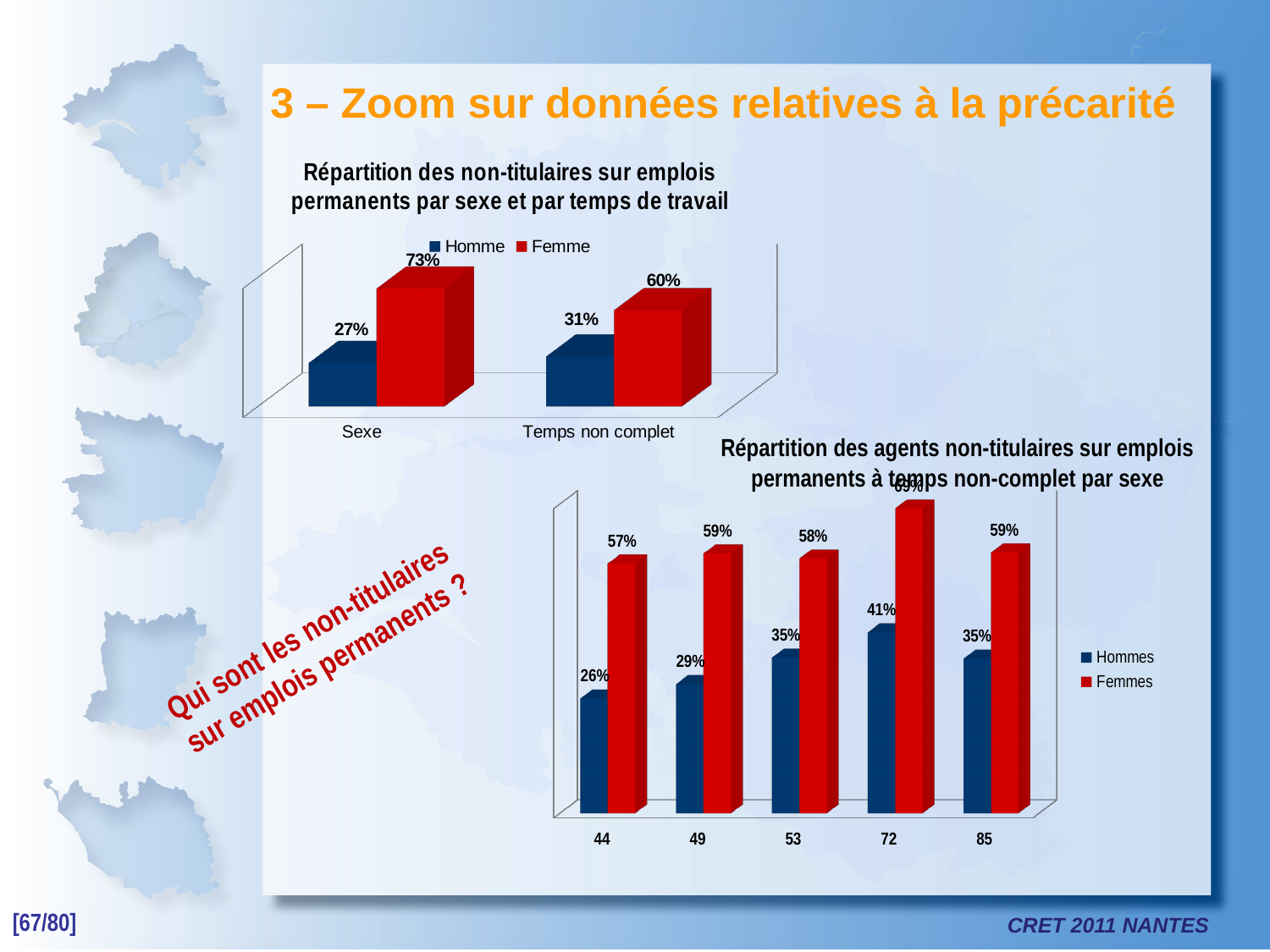
What kind of chart is the bottom chart? Bar chart In the bottom chart, what is the difference between the Femmes and Hommes values for category 49? 30% In the top chart, which series has the larger value in the Temps non complet category, Homme or Femme? Femme In the top chart, what is the difference between the Femme and Homme values in the Sexe category? 46% How many categories are shown on the x axis of the bottom chart? 5 In the bottom chart, which category has the lowest Hommes value? 44 In the bottom chart, which category has the highest Hommes value? 72 In the bottom chart (Répartition des agents non-titulaires sur emplois permanents à temps non-complet par sexe), what is the Hommes value for category 44? 26% In the top chart (Répartition des non-titulaires sur emplois permanents par sexe et par temps de travail), what is the value for Femme in the Sexe category? 73% How many series does the legend of the top chart list? 2 In the top chart, what is the value for Homme in the Temps non complet category? 31% In the bottom chart, what is the Femmes value for category 53? 58%